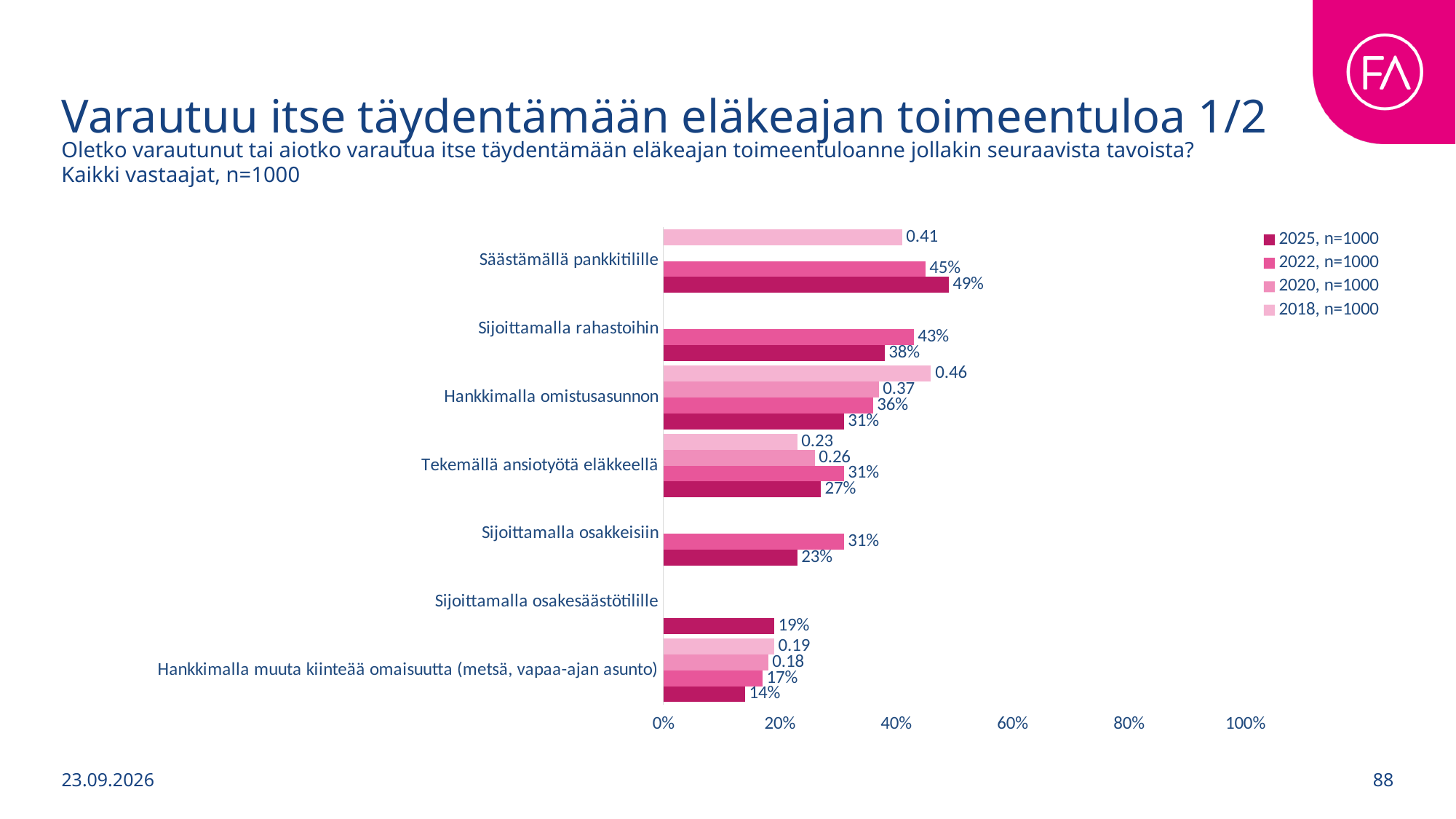
Which category has the lowest 2025 value? Hankkimalla muuta kiinteää omaisuutta (metsä, vapaa-ajan asunto) What is the 2018 value for Hankkimalla omistusasunnon? 0.46 What kind of chart is shown on the slide? bar chart How many categories are shown on the chart? 7 What is the 2020 value for Tekemällä ansiotyötä eläkkeellä? 0.26 Which category has the highest 2025 value? Säästämällä pankkitilille What is the 2025 value for Säästämällä pankkitilille? 49% How many series does the legend list? 4 What is the difference between the 2022 and 2025 values for Sijoittamalla osakkeisiin? 8% What is the 2022 value for Sijoittamalla rahastoihin? 43% Which is larger for Hankkimalla omistusasunnon: the 2022 value or the 2025 value? 2022 Which series is shown in the darkest colour in the legend? 2025, n=1000